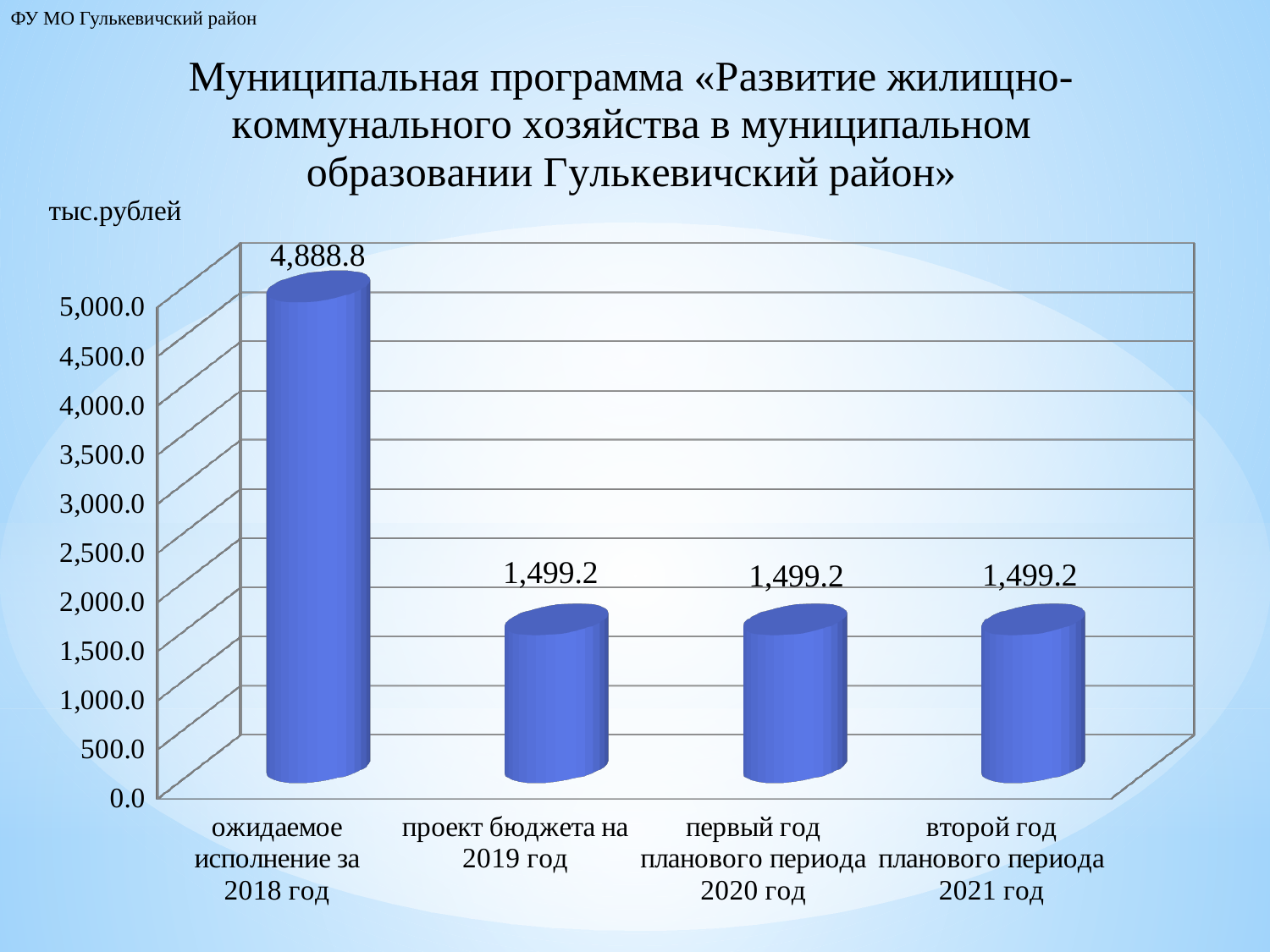
What kind of chart is shown on the slide? bar chart What is the value for «ожидаемое исполнение за 2018 год»? 4,888.8 What is the difference between the value for 2018 (ожидаемое исполнение) and the value for проект бюджета на 2019 год? 3,389.6 What is the value for «проект бюджета на 2019 год»? 1,499.2 Which is larger: the value for ожидаемое исполнение за 2018 год or the value for проект бюджета на 2019 год? ожидаемое исполнение за 2018 год How many categories are shown on the chart? 4 What is the value for «второй год планового периода 2021 год»? 1,499.2 Is the value for ожидаемое исполнение за 2018 год greater or less than 4,500.0? greater What is the value for «первый год планового периода 2020 год»? 1,499.2 Is the value for второй год планового периода 2021 год greater or less than 2,000.0? less In what units are the values on the chart expressed? тыс.рублей Which category has the highest value? ожидаемое исполнение за 2018 год